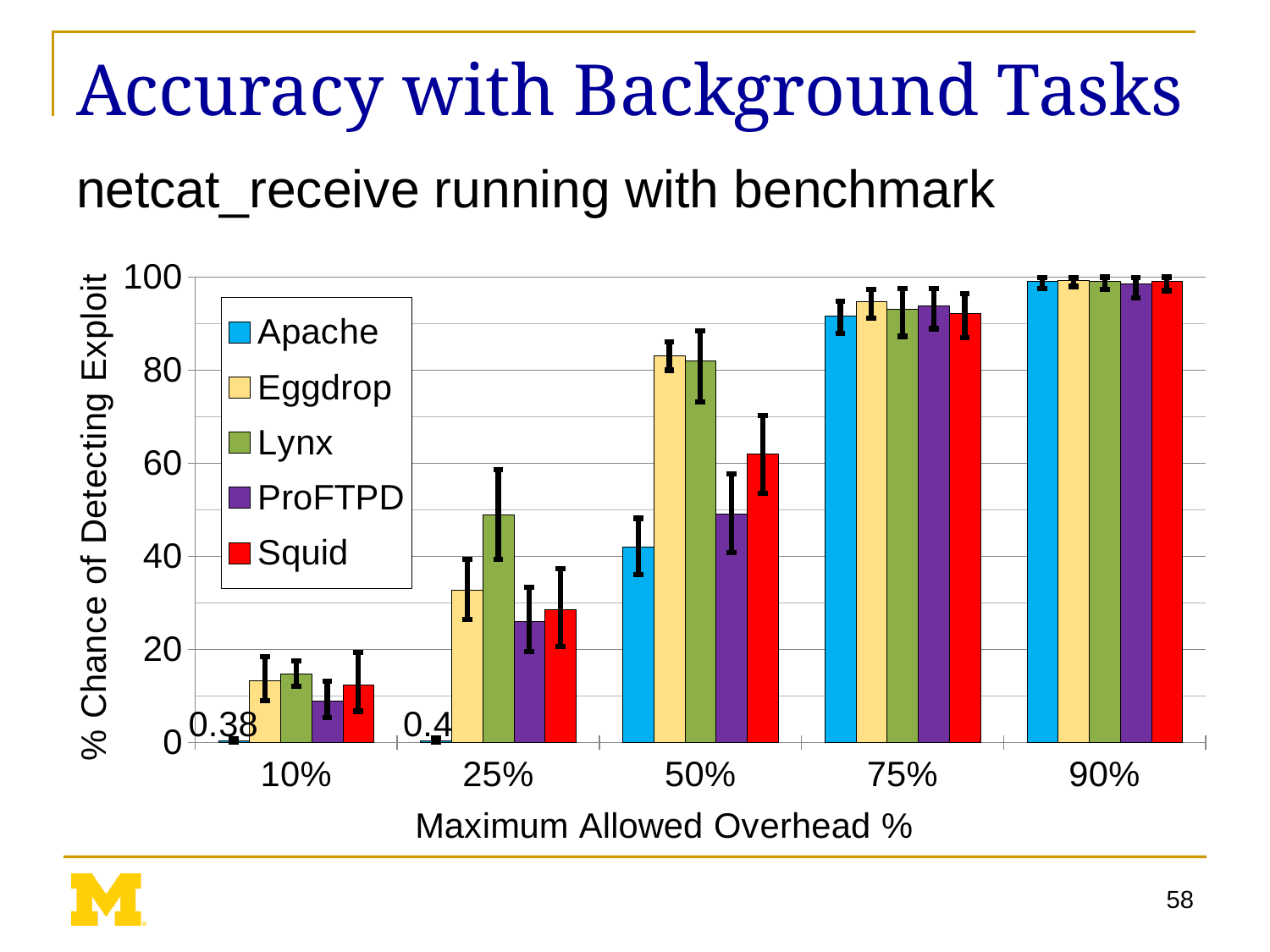
What is the difference between the Apache values at 25% and 10% maximum allowed overhead? 0.02 What is the value for Apache at 25% maximum allowed overhead? 0.4 Do the Eggdrop values rise or fall as maximum allowed overhead increases from 10% to 90%? rise At 50% maximum allowed overhead, which is larger, Eggdrop or Apache? Eggdrop What kind of chart is shown on the slide? bar chart Is the value for Apache at 50% maximum allowed overhead greater or less than 60? less How many series does the legend list? 5 What is the title of the x axis? Maximum Allowed Overhead % What is the value for Apache at 10% maximum allowed overhead? 0.38 How many maximum allowed overhead categories are shown on the x axis? 5 At 25% maximum allowed overhead, which series has the highest value? Lynx Is the value for Eggdrop at 50% maximum allowed overhead greater or less than 60? greater